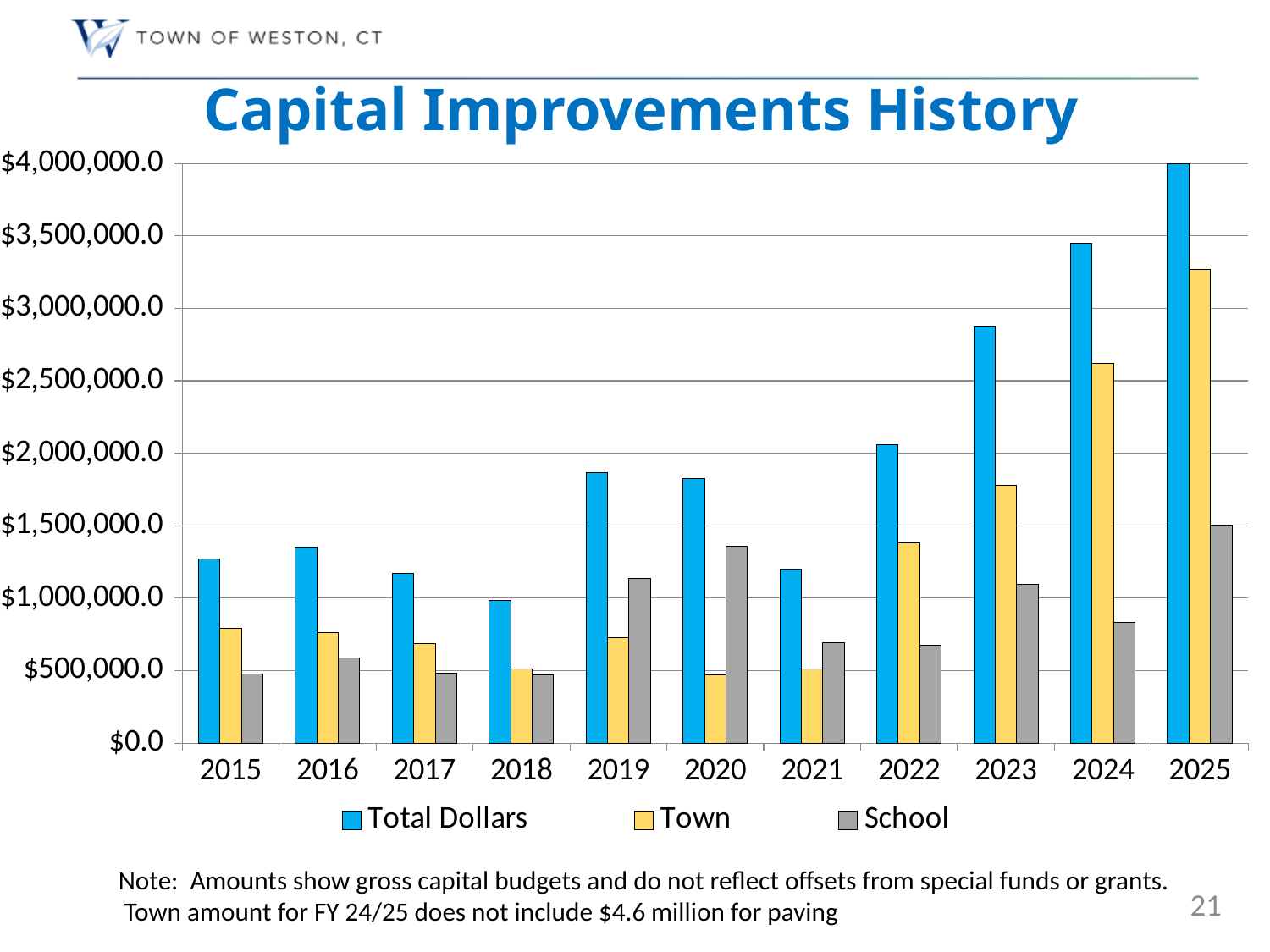
Is the Town value for 2024 greater or less than $2,500,000.0? greater Which year has the highest Total Dollars value? 2025 Is the Total Dollars value for 2023 greater or less than $2,500,000.0? greater In 2019, which is larger, the Town value or the School value? School Which year has the lowest Total Dollars value? 2018 How many series does the legend list? 3 How many years are shown on the x axis? 11 What kind of chart is shown on the slide? bar chart Which year has the highest Town value? 2025 Do the Total Dollars values rise or fall from 2022 to 2025? rise In 2022, which is larger, the Town value or the School value? Town Which year has the highest School value? 2025